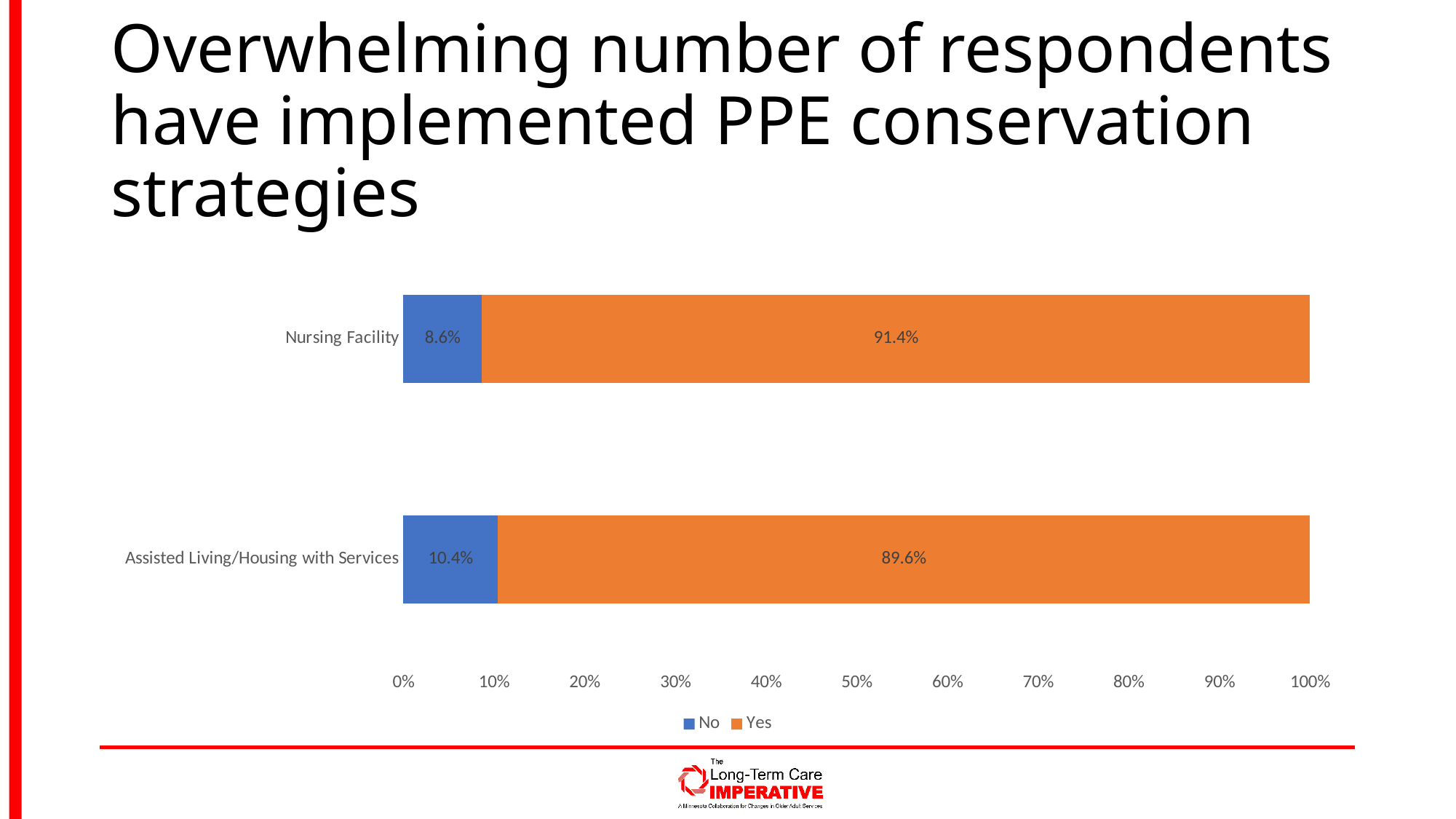
What percentage of Assisted Living/Housing with Services respondents answered Yes? 89.6% How many categories are shown on the chart? 2 What percentage of Nursing Facility respondents answered Yes? 91.4% How many series does the legend list? 2 What is the difference between the Yes percentages for Nursing Facility and Assisted Living/Housing with Services? 1.8% What percentage of Assisted Living/Housing with Services respondents answered No? 10.4% Which category has the lower No percentage? Nursing Facility Is the No percentage for Assisted Living/Housing with Services larger or smaller than the No percentage for Nursing Facility? larger Which colour represents the Yes series in the chart? orange What kind of chart is shown on the slide? stacked bar chart What percentage of Nursing Facility respondents answered No? 8.6% Which category has the higher Yes percentage? Nursing Facility